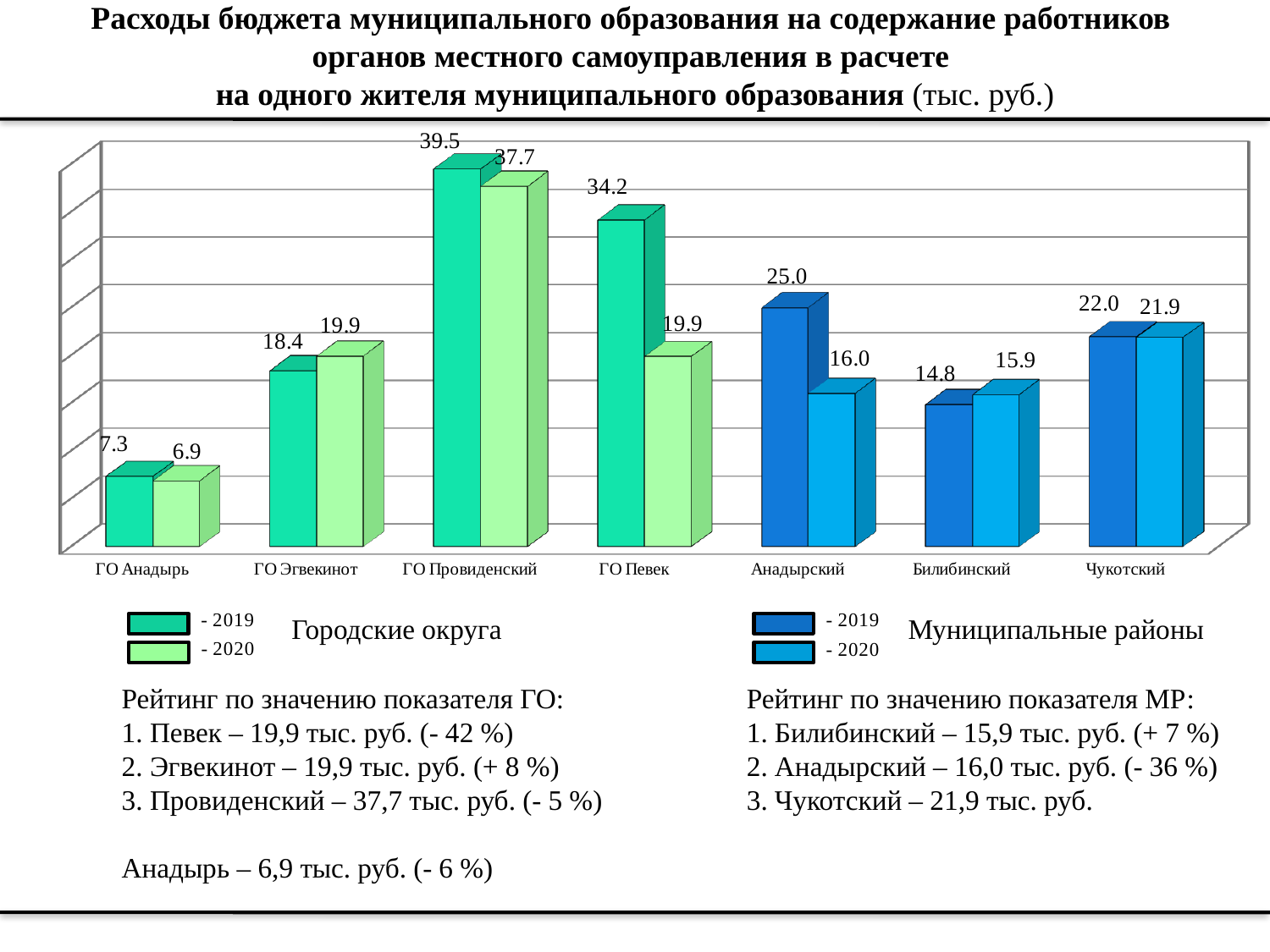
What is the 2019 value for ГО Провиденский? 39.5 What is the 2020 value for ГО Эгвекинот? 19.9 Which category has the highest 2019 value? ГО Провиденский How many municipalities (categories) are shown on the chart? 7 Which has the larger 2019 value, Анадырский or Чукотский? Анадырский Which two years does the chart legend list? 2019 and 2020 Which category has the lowest 2020 value? ГО Анадырь What is the difference between the 2019 and 2020 values for Чукотский? 0.1 What is the 2020 value for Анадырский? 16.0 What type of chart is shown on the slide? Bar chart By how much did the value for ГО Певек fall from 2019 to 2020? 14.3 For Билибинский, which year has the larger value, 2019 or 2020? 2020